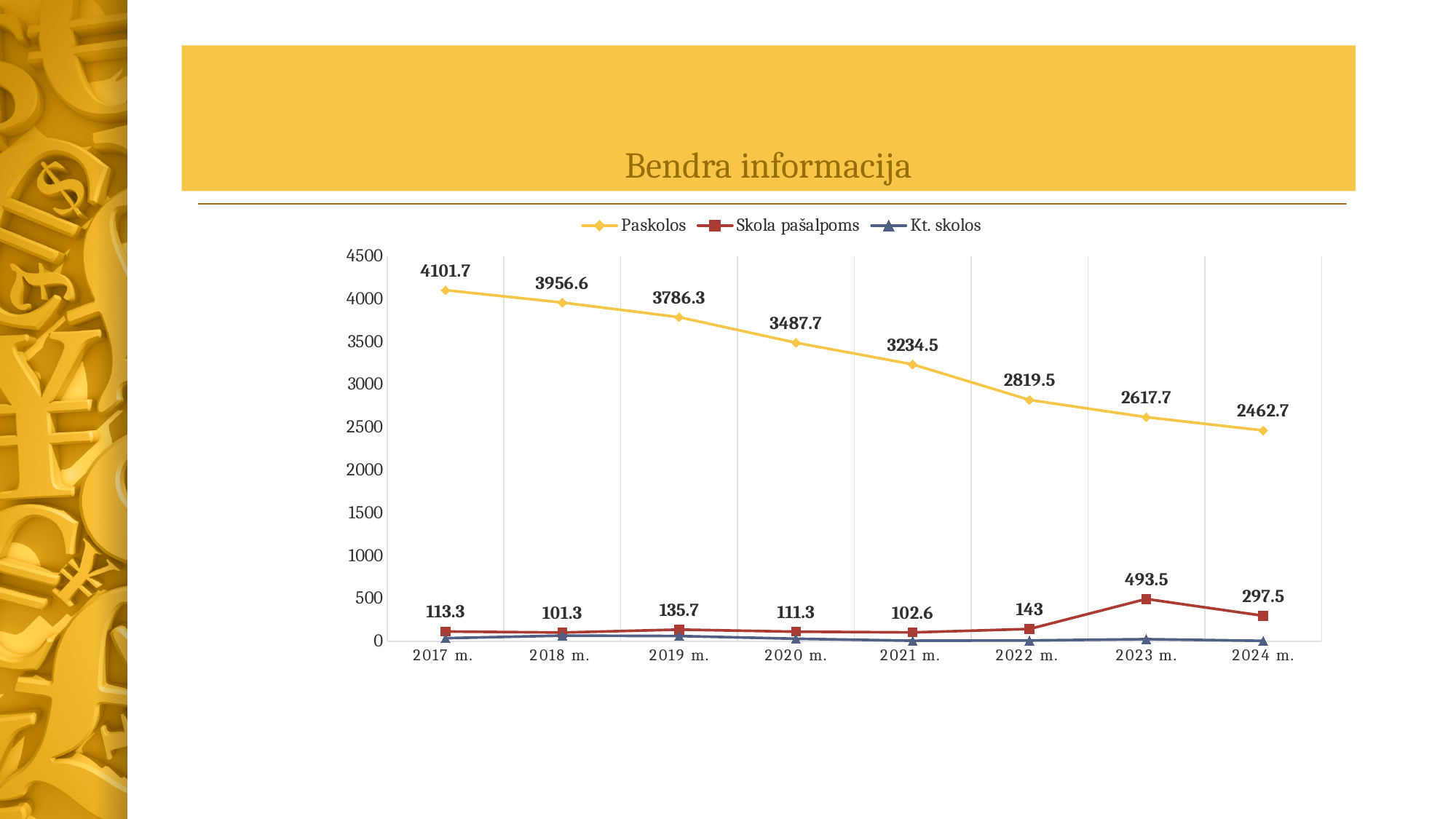
How many years are shown on the x axis? 8 Which is larger: Skola pašalpoms in 2022 m. or in 2021 m.? 2022 m. In which year is Paskolos lowest? 2024 m. What is the value of Paskolos in 2017 m.? 4101.7 Does the Paskolos series rise or fall from 2017 m. to 2024 m.? fall What is the difference between Paskolos in 2017 m. and 2024 m.? 1639 What is the value of Skola pašalpoms in 2023 m.? 493.5 Is the value of Paskolos in 2020 m. greater or less than 3500? less In which year is Skola pašalpoms highest? 2023 m. What kind of chart is shown on the slide? line chart What is the value of Paskolos in 2024 m.? 2462.7 How many series does the legend list? 3